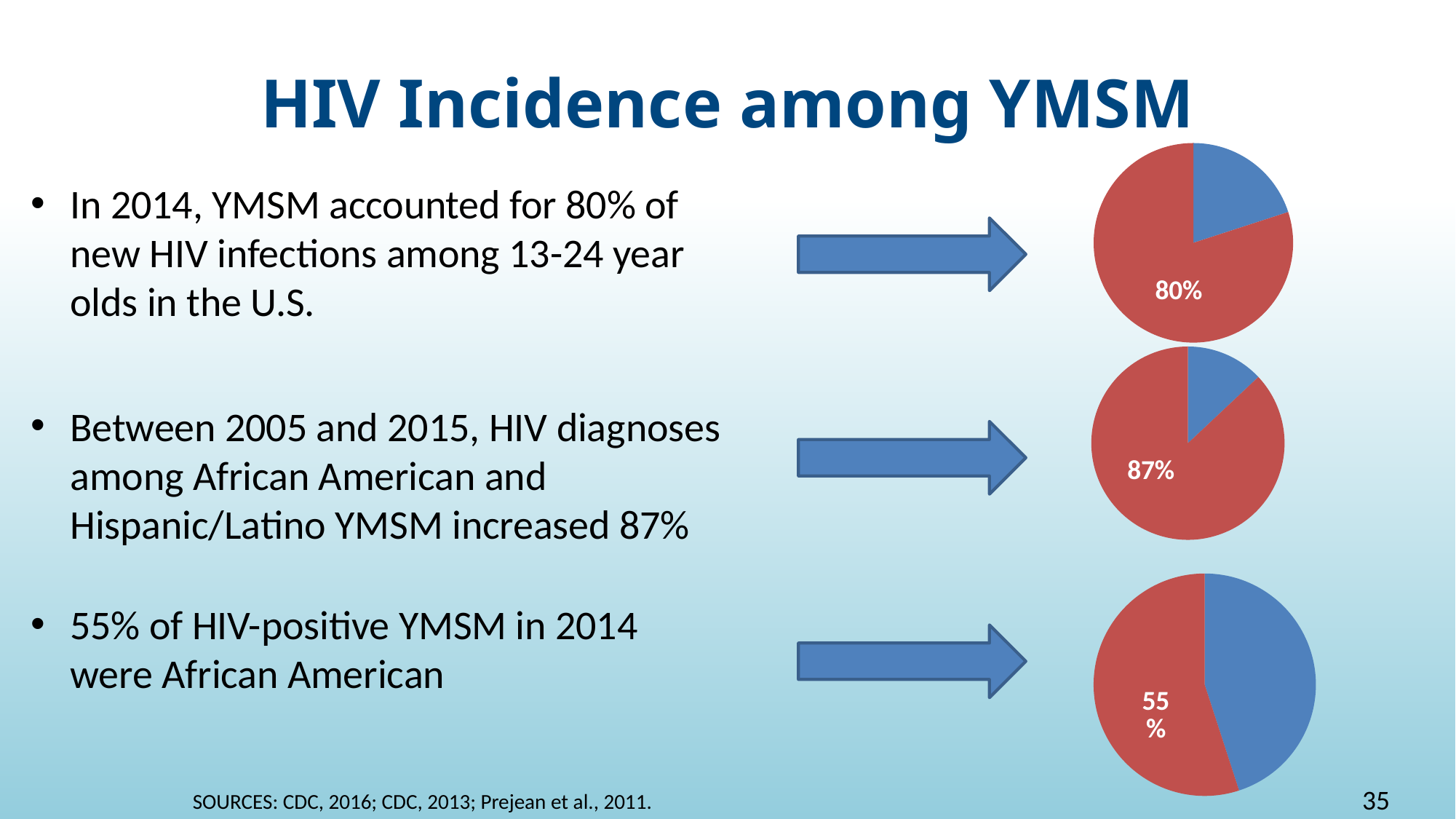
Which of the three pie charts has the smallest labeled red slice? the bottom pie chart (55%) How many pie charts are shown on the slide? 3 Which is larger: the labeled slice in the top pie chart or the labeled slice in the bottom pie chart? the top pie chart (80%) In the bottom pie chart, which slice is larger, the red one or the blue one? the red one What colour is the slice that carries the percentage label in each pie chart? red What kind of chart is the top chart on the right of the slide? pie chart In the bottom pie chart, what percentage is printed on the red slice? 55% In the top pie chart, what percentage is printed on the red slice? 80% Which of the three pie charts has the largest labeled red slice? the middle pie chart (87%) How many slices does the top pie chart have? 2 In the middle pie chart, what percentage is printed on the red slice? 87% What is the difference between the labeled value in the middle pie chart and the labeled value in the top pie chart? 7 percentage points